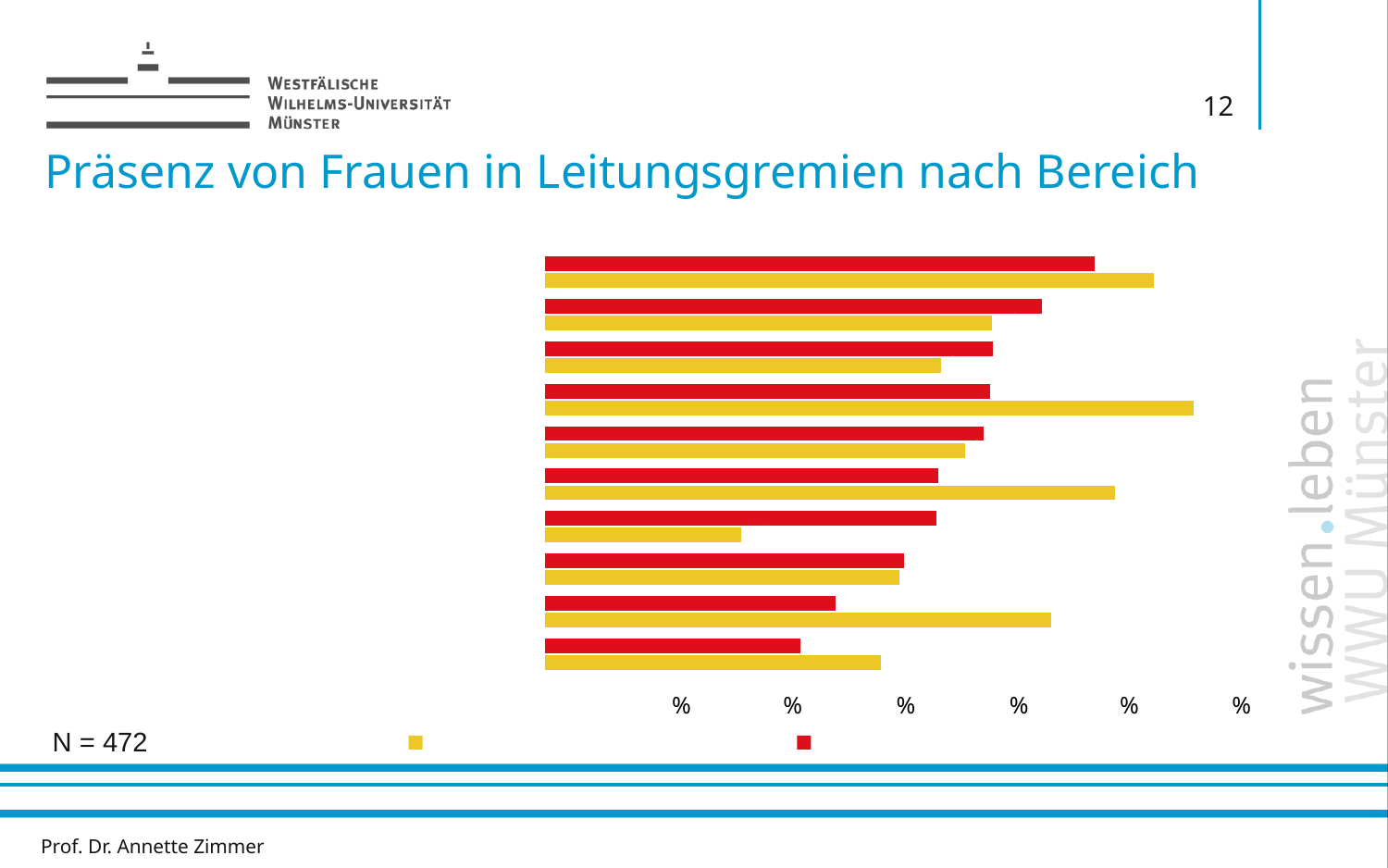
How many bars are plotted in total in the chart? 20 In the top pair of bars, which bar is longer, the red or the yellow one? yellow How many series does the legend list? 2 What sample size (N) is stated on the slide? N = 472 What is the title of the chart on the slide? Präsenz von Frauen in Leitungsgremien nach Bereich In the bottom pair of bars, which bar is longer, the red or the yellow one? yellow How many categories (pairs of bars) are plotted in the chart? 10 Which series contains the single longest bar in the chart, the red or the yellow one? yellow What kind of chart is shown on the slide? bar chart Do the red bars get longer or shorter going from the top of the chart to the bottom? shorter Which two colours are used for the bars in the chart? red and yellow